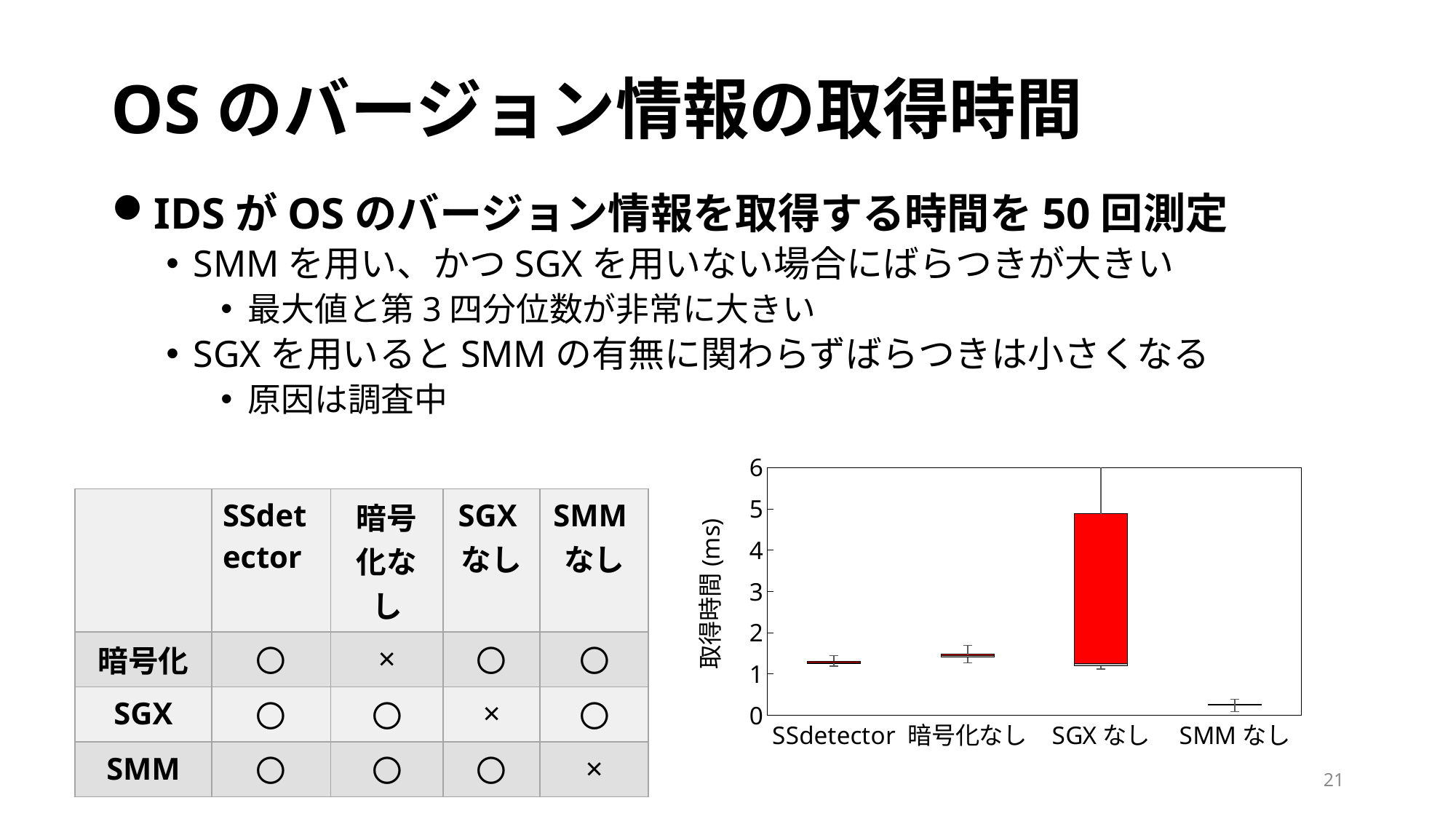
Is the median value for SMM なし greater or less than 1 ms? less What is the label of the y axis of the chart? 取得時間 (ms) How many categories are shown on the x axis of the chart? 4 Is the median value for 暗号化なし greater or less than 2 ms? less Is the median value for SSdetector greater or less than 1 ms? greater Which has a higher upper quartile, SGX なし or 暗号化なし? SGX なし Which category in the chart shows the largest spread (tallest box) of acquisition time? SGX なし What kind of chart is shown on the slide? Box plot Which has a higher median acquisition time, SSdetector or SMM なし? SSdetector Which category in the chart has the lowest acquisition time? SMM なし Which category's box is filled in red in the chart? SGX なし